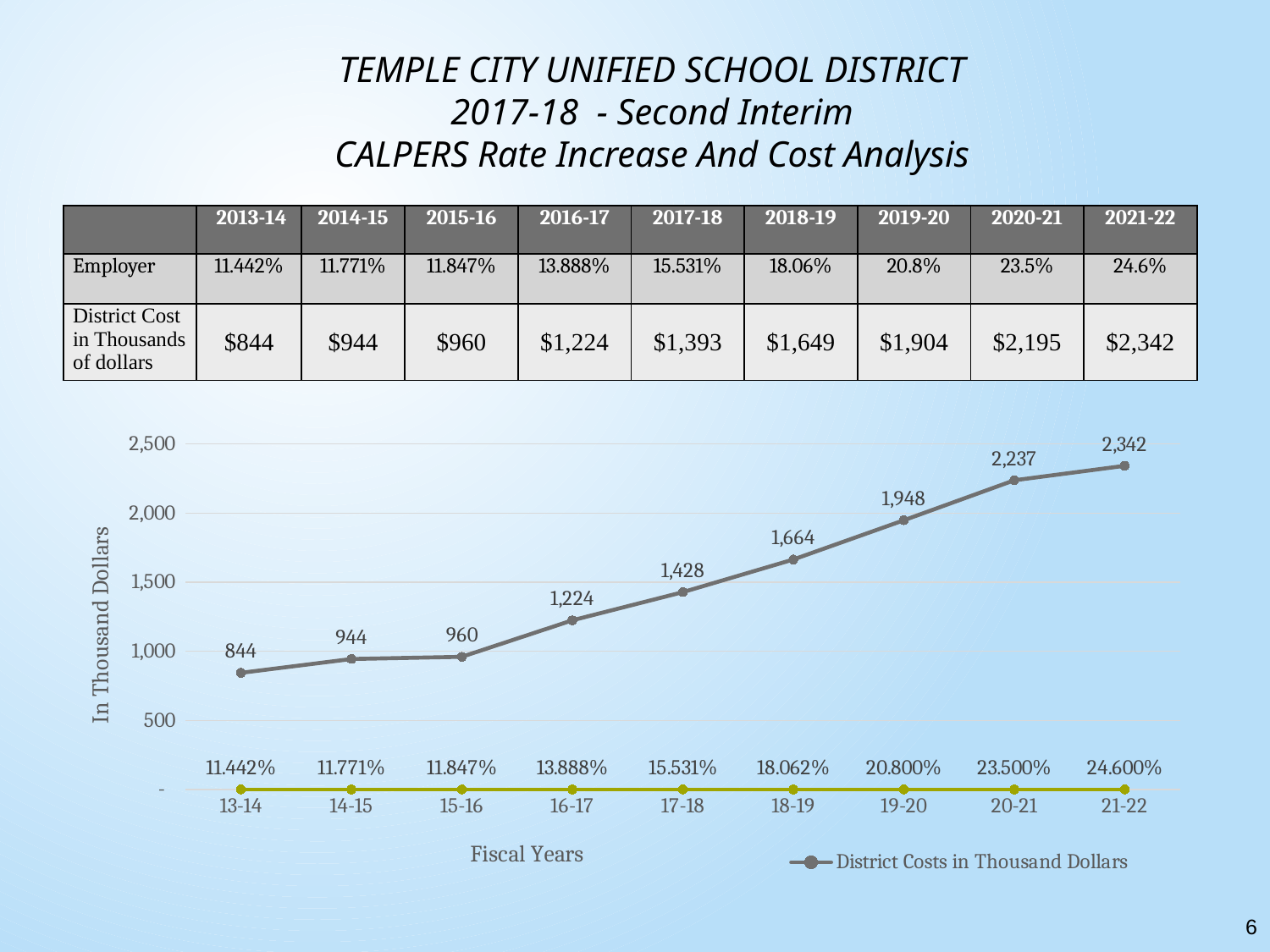
In the chart, what is the difference between the District Costs values for 21-22 and 20-21? 105 What type of chart is shown on the slide? line chart In the chart, which fiscal year has the lowest District Costs value? 13-14 In the chart, what is the difference between the District Costs values for 17-18 and 16-17? 204 Do the District Costs values rise or fall from 13-14 to 21-22 in the chart? rise How many fiscal years are plotted on the x axis of the chart? 9 In the chart, what is the District Costs value for fiscal year 13-14? 844 In the chart, what is the District Costs value for fiscal year 16-17? 1,224 In the chart, what is the District Costs value for fiscal year 19-20? 1,948 In the chart, which is larger, the District Costs value for 15-16 or for 14-15? 15-16 In the chart, which fiscal year has the highest District Costs value? 21-22 What is the label on the y axis of the chart? In Thousand Dollars